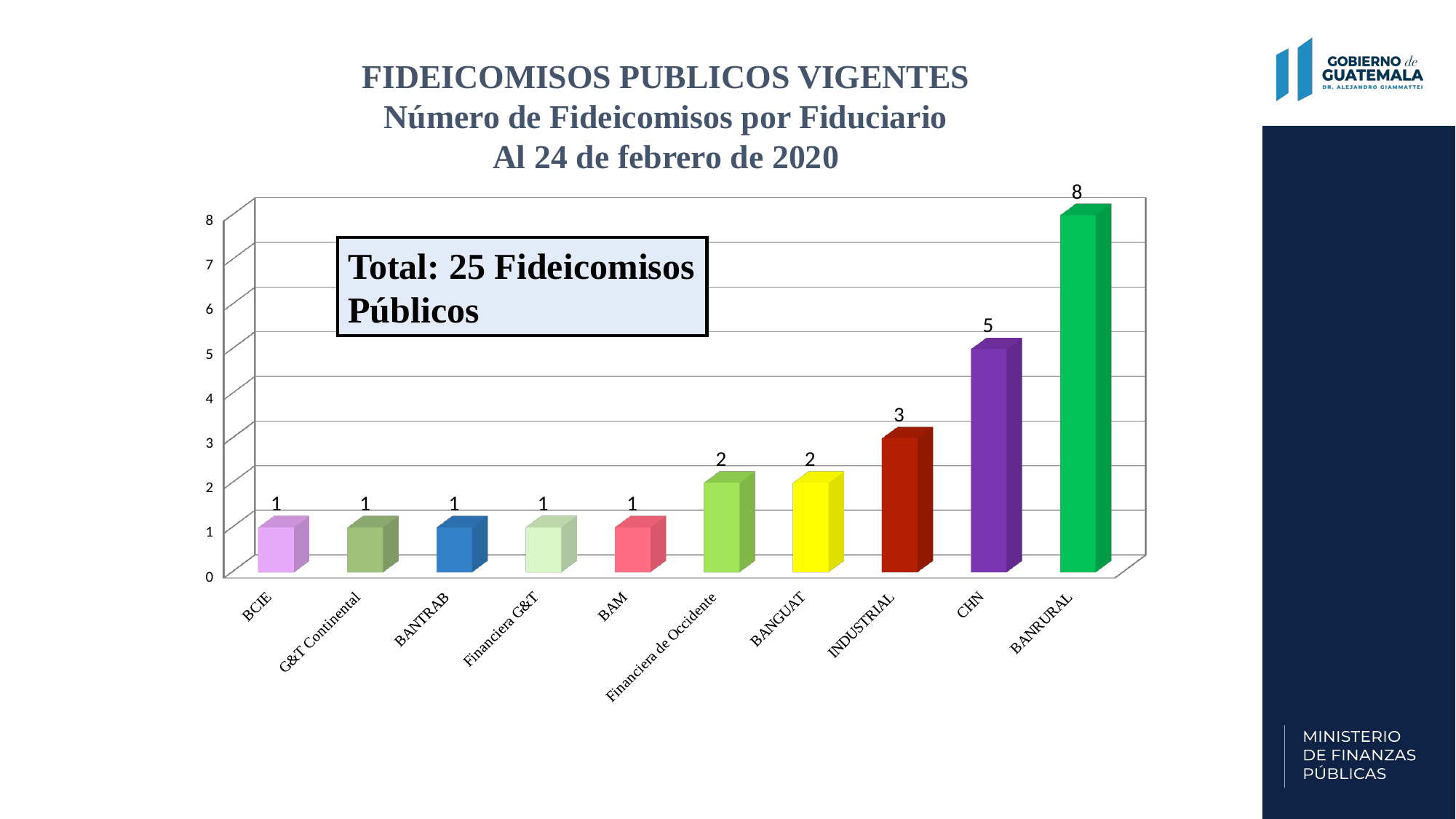
What is the difference between the values for BANRURAL and CHN? 3 Do the values rise or fall from left to right along the x axis? Rise How many fiduciarios are shown on the x axis? 10 What is the value for BANRURAL? 8 Which is larger, the value for INDUSTRIAL or the value for Financiera de Occidente? INDUSTRIAL What is the value for BANGUAT? 2 How many fiduciarios have a value of 1? 5 What is the value for CHN? 5 What is the value for INDUSTRIAL? 3 What kind of chart is shown on the slide? Bar chart What total number of fideicomisos públicos is stated in the box on the chart? 25 Which fiduciario has the highest number of fideicomisos? BANRURAL